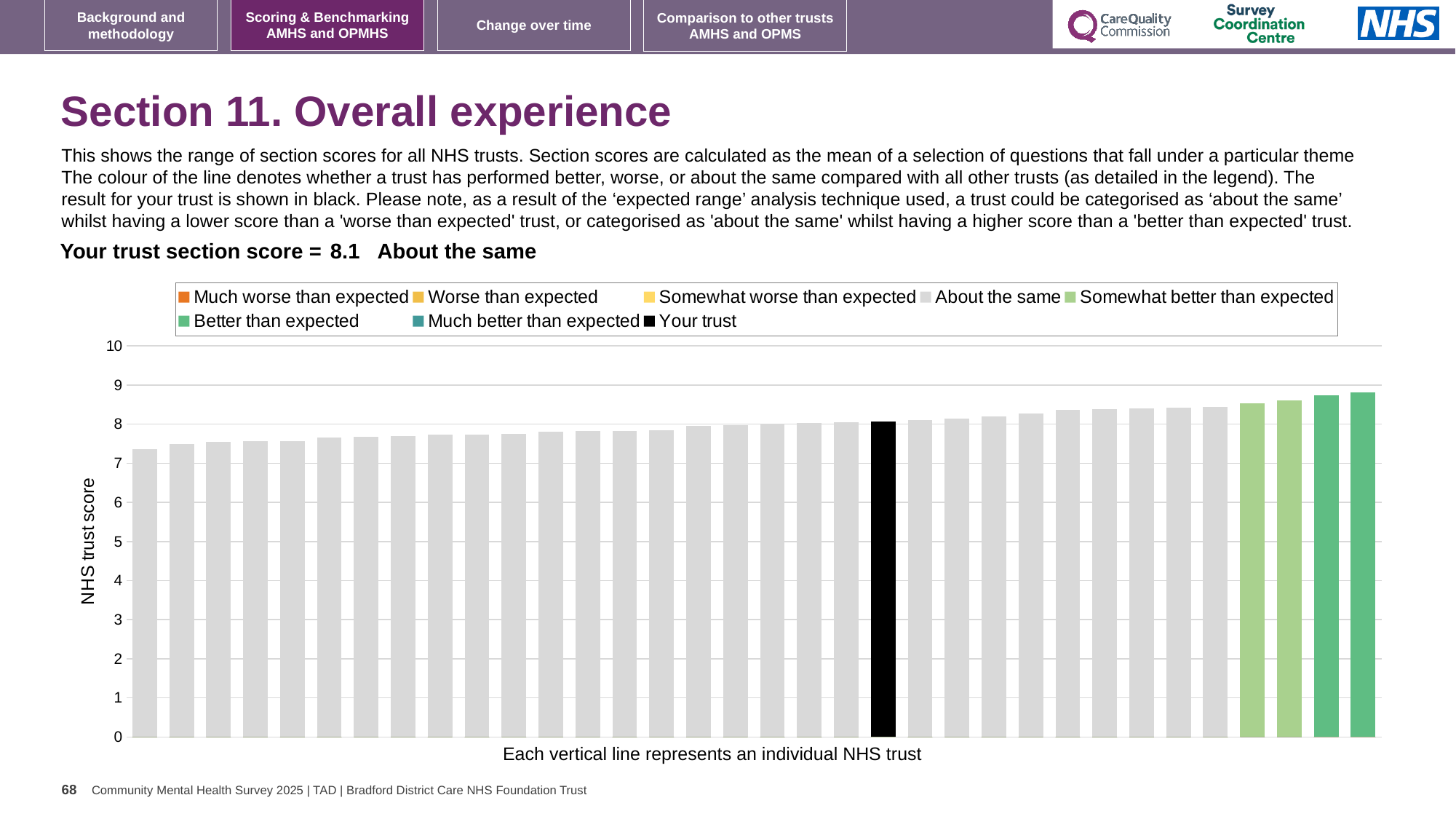
What is the section score for your trust shown on the slide? 8.1 Do the bar values rise or fall from left to right along the x axis? rise How many entries does the chart legend list? 8 Which category is your trust placed in for this section? About the same What kind of chart is shown on the slide? bar chart What colour is the bar representing your trust? black How many bars are coloured as 'Much worse than expected' (orange)? 0 Is the value of the highest bar greater or less than 9? less How many bars are coloured as 'Somewhat better than expected' (light green)? 2 How many bars are coloured as 'Better than expected' (darker green)? 2 Is the value of the lowest bar greater or less than 7? greater